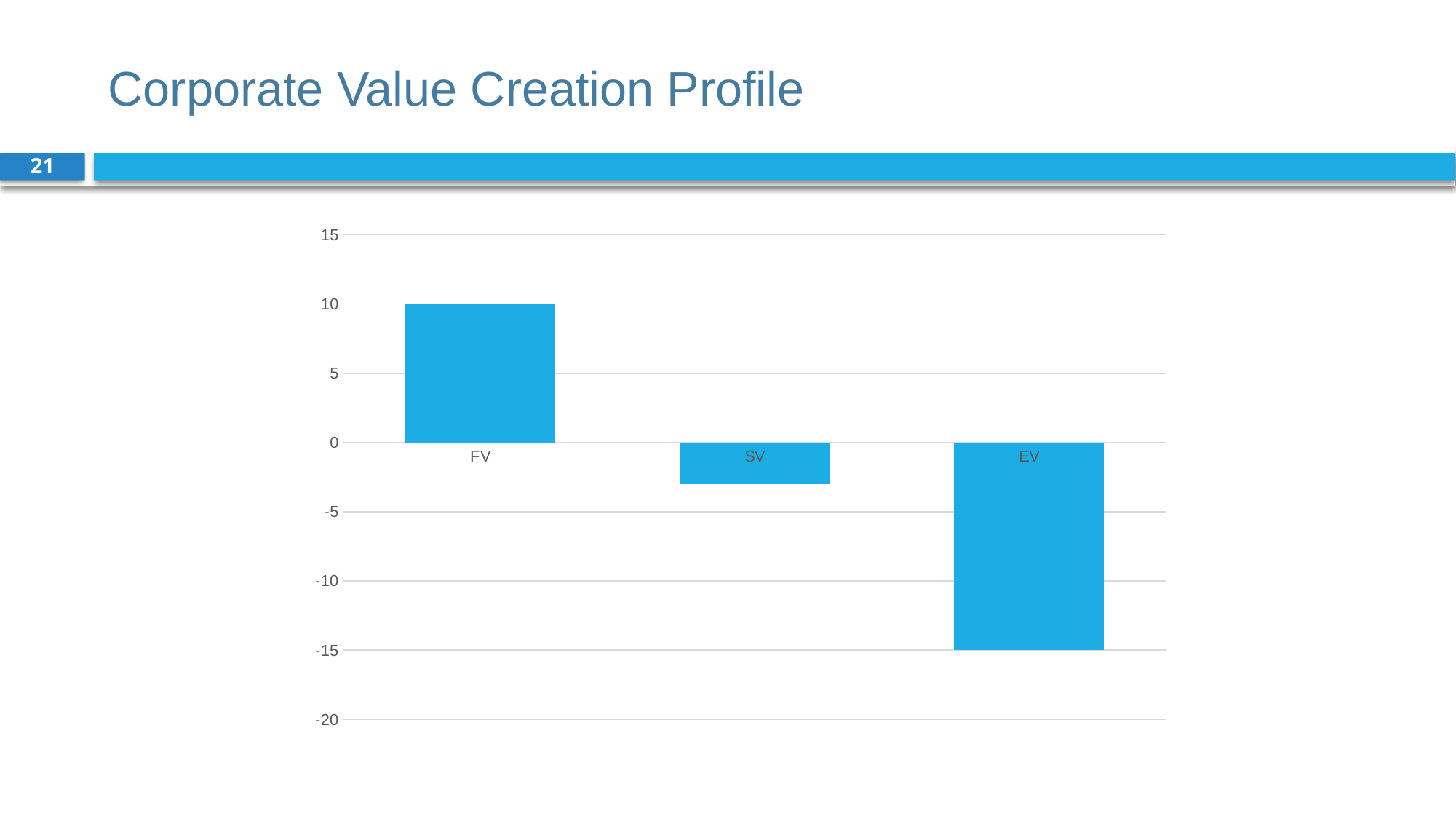
What is the value for EV? -15 What kind of chart is shown on the slide? bar chart What is the difference between the value for FV and the value for EV? 25 How many categories are plotted on the chart? 3 Which category has the highest value? FV What is the title of the slide containing the chart? Corporate Value Creation Profile Which category has the lowest value? EV Which is larger, the value for FV or the value for SV? FV Is the value for SV greater or less than -5? greater Do the values rise or fall moving from FV to EV along the x axis? fall Is the value for SV greater or less than 0? less What is the value for FV? 10